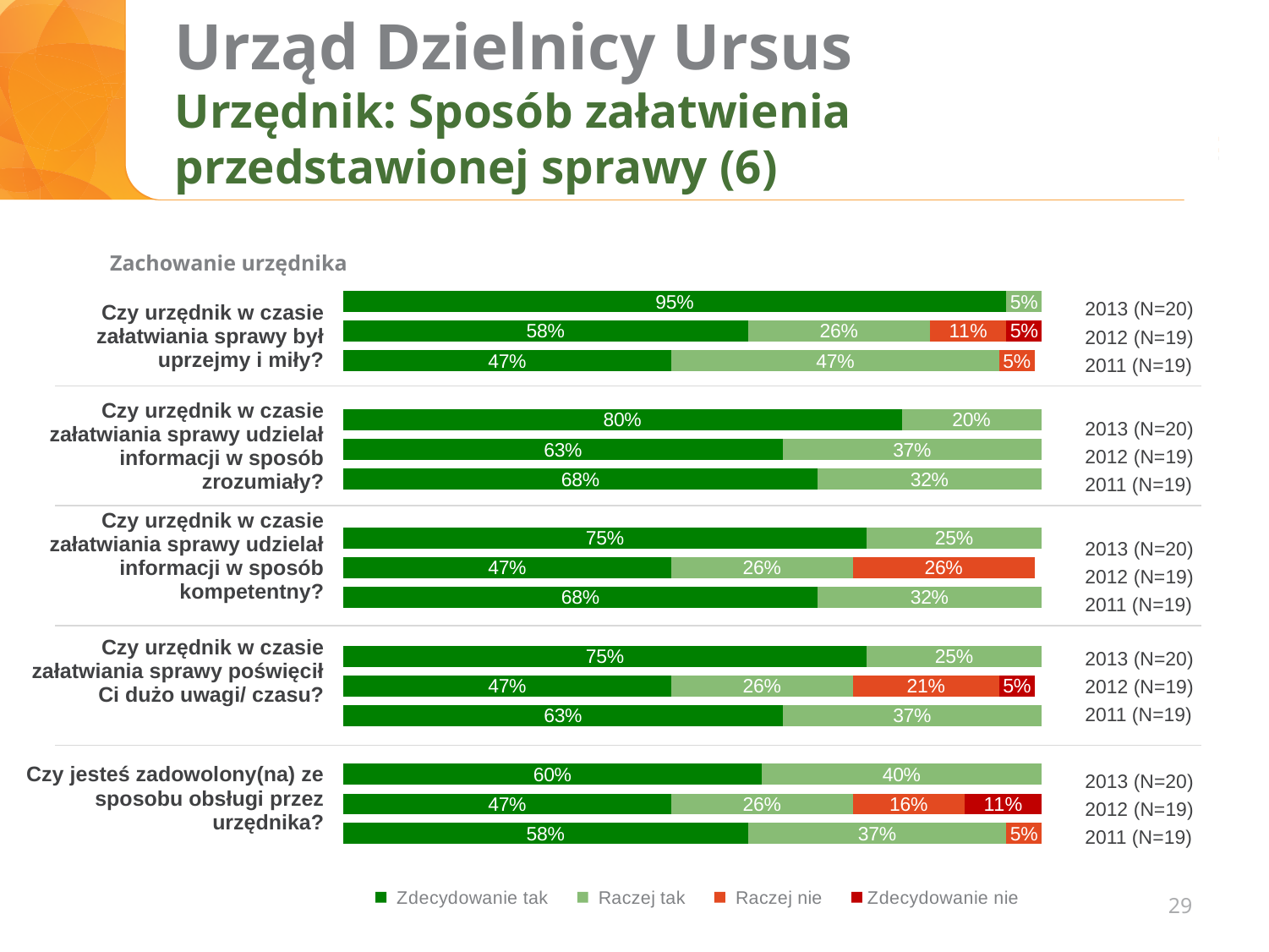
How many response categories does the legend list? 4 What percentage answered "Zdecydowanie nie" in 2012 to "Czy jesteś zadowolony(na) ze sposobu obsługi przez urzędnika?"? 11% For "Czy urzędnik w czasie załatwiania sprawy udzielał informacji w sposób zrozumiały?", which year had the larger "Zdecydowanie tak" share, 2012 or 2011? 2011 What percentage answered "Raczej nie" in 2012 to "Czy urzędnik w czasie załatwiania sprawy udzielał informacji w sposób kompetentny?"? 26% For "Czy urzędnik w czasie załatwiania sprawy poświęcił Ci dużo uwagi/ czasu?", what is the difference in the "Zdecydowanie tak" share between 2013 and 2011? 12 percentage points What type of chart is shown on the slide? Stacked bar chart What percentage answered "Raczej tak" in 2013 to "Czy jesteś zadowolony(na) ze sposobu obsługi przez urzędnika?"? 40% How many survey questions are shown in the chart? 5 What percentage answered "Zdecydowanie tak" in 2013 to "Czy urzędnik w czasie załatwiania sprawy był uprzejmy i miły?"? 95% What is the combined share of "Raczej nie" and "Zdecydowanie nie" in 2012 for "Czy urzędnik w czasie załatwiania sprawy był uprzejmy i miły?"? 16% What percentage answered "Raczej tak" in 2012 to "Czy urzędnik w czasie załatwiania sprawy udzielał informacji w sposób zrozumiały?"? 37% For "Czy urzędnik w czasie załatwiania sprawy był uprzejmy i miły?", which year has the highest "Zdecydowanie tak" share? 2013 (N=20)